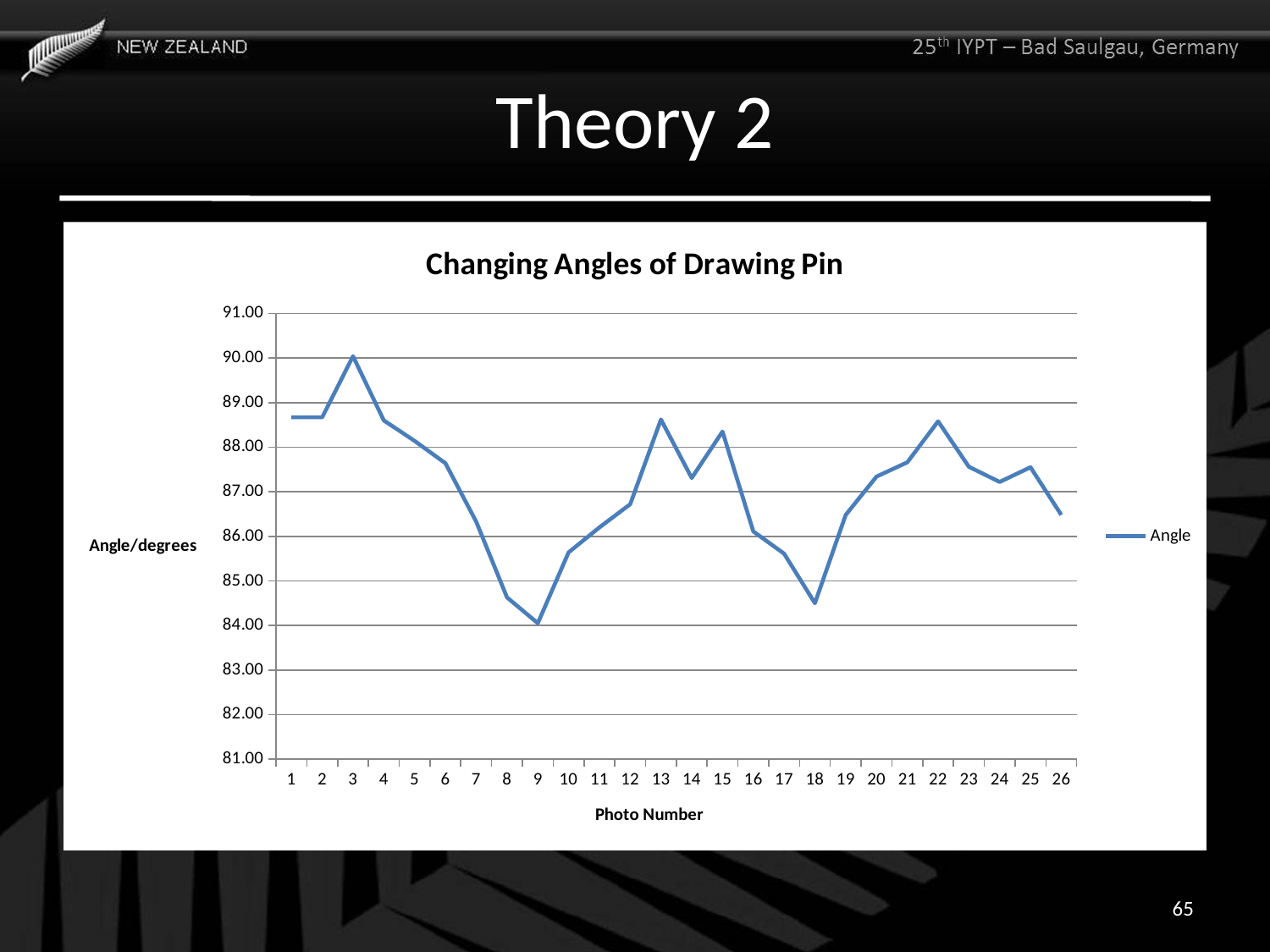
How many photo numbers are plotted along the x axis? 26 Do the angle values rise or fall from photo 3 to photo 9? fall What is the title of the chart? Changing Angles of Drawing Pin Which has the larger angle, photo 13 or photo 18? photo 13 Is the angle for photo 9 greater or less than 85.00? less What kind of chart is shown on the slide? line chart How many series does the legend list? 1 Is the angle for photo 3 greater or less than 89.00? greater What is the label of the y axis? Angle/degrees Which photo number has the lowest angle? 9 Which photo number has the highest angle? 3 Is the angle for photo 26 greater or less than 87.00? less